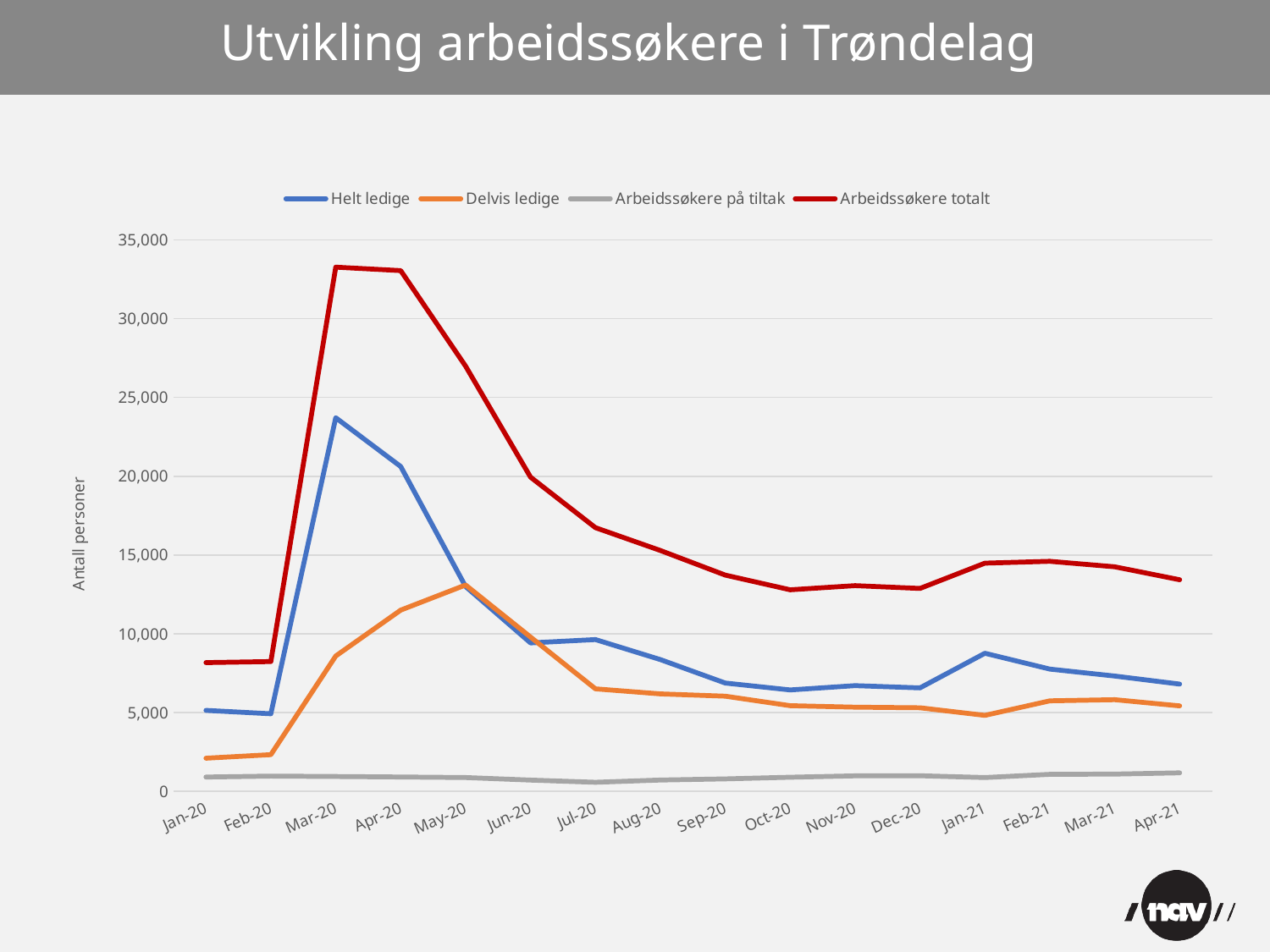
In Apr-20, which is larger: Helt ledige or Delvis ledige? Helt ledige In which month does the Delvis ledige series reach its highest value? May-20 In which month does the Helt ledige series reach its highest value? Mar-20 Which series has the lowest values across the whole period? Arbeidssøkere på tiltak What is the label on the y axis? Antall personer What kind of chart is shown on the slide? Line chart Is the value for Arbeidssøkere totalt in Mar-20 greater or less than 30,000? greater How many months are shown along the x axis? 16 Does the Arbeidssøkere totalt series rise or fall from Apr-20 to Oct-20? Fall How many series does the legend list? 4 Is the value for Arbeidssøkere totalt in Apr-21 greater or less than 15,000? less Is the value for Helt ledige in Jan-21 greater or less than 10,000? less